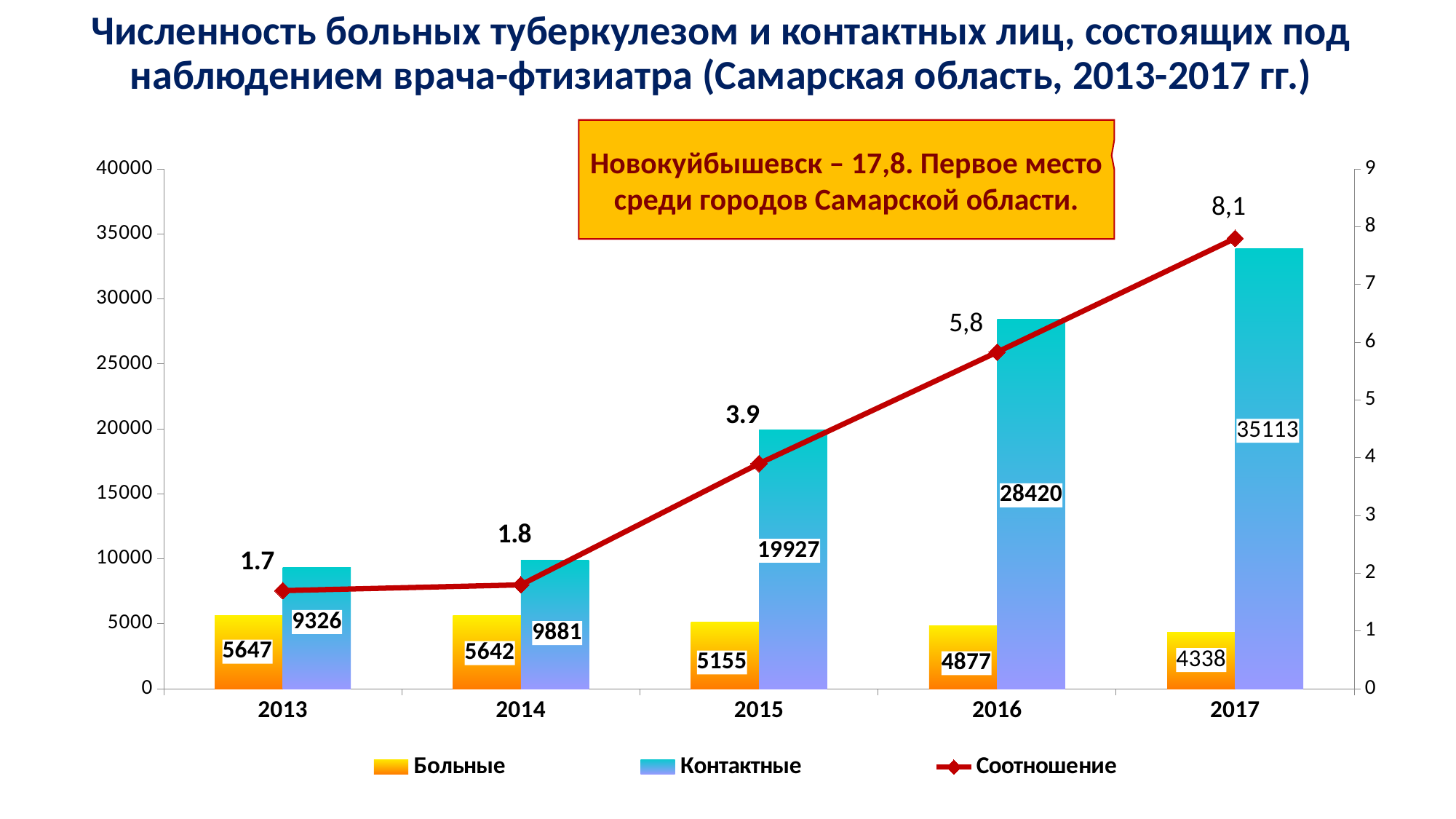
What is the Соотношение value for 2015? 3.9 What is the value for Контактные in 2017? 35113 In which year is the Больные value lowest? 2017 Which is larger: the Больные value for 2014 or for 2016? 2014 Which series is drawn as a line with diamond markers? Соотношение In which year is the Контактные value highest? 2017 Does the Контактные value rise or fall from 2013 to 2017? rise How many series does the legend list? 3 What is the Соотношение value for 2017? 8,1 How many years are shown on the x axis? 5 What is the difference between the Контактные values for 2016 and 2015? 8493 What is the value for Больные in 2013? 5647